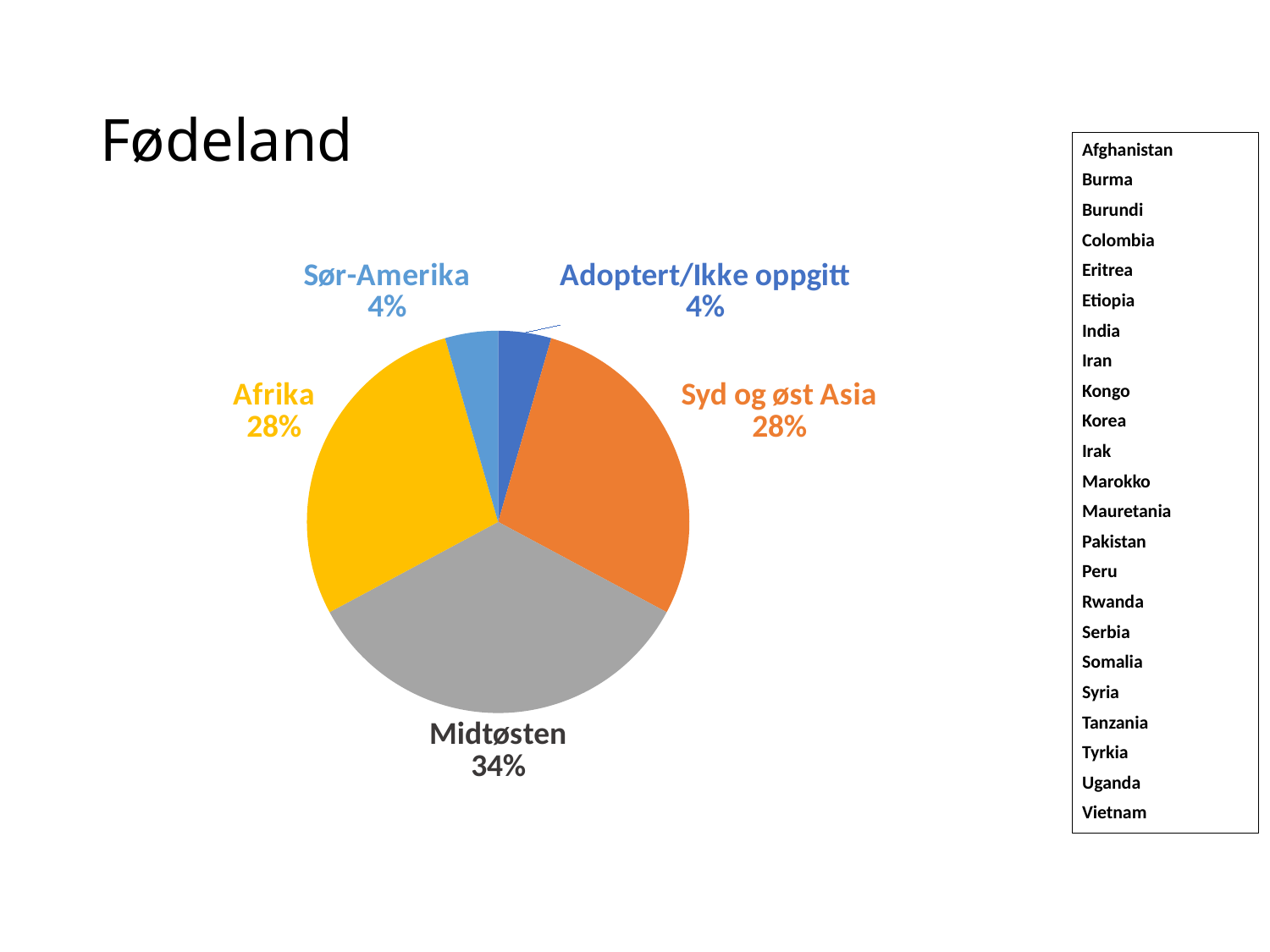
What kind of chart is shown on the slide? pie chart What share of the pie does Midtøsten have? 34% Which is larger, the slice for Midtøsten or the slice for Syd og øst Asia? Midtøsten What share of the pie does Adoptert/Ikke oppgitt have? 4% What share of the pie does Afrika have? 28% Which category has the largest slice of the pie? Midtøsten How many slices does the pie chart have? 5 What is the difference in percentage points between Midtøsten and Afrika? 6 What is the title of the slide containing the pie chart? Fødeland What is the difference in percentage points between Syd og øst Asia and Sør-Amerika? 24